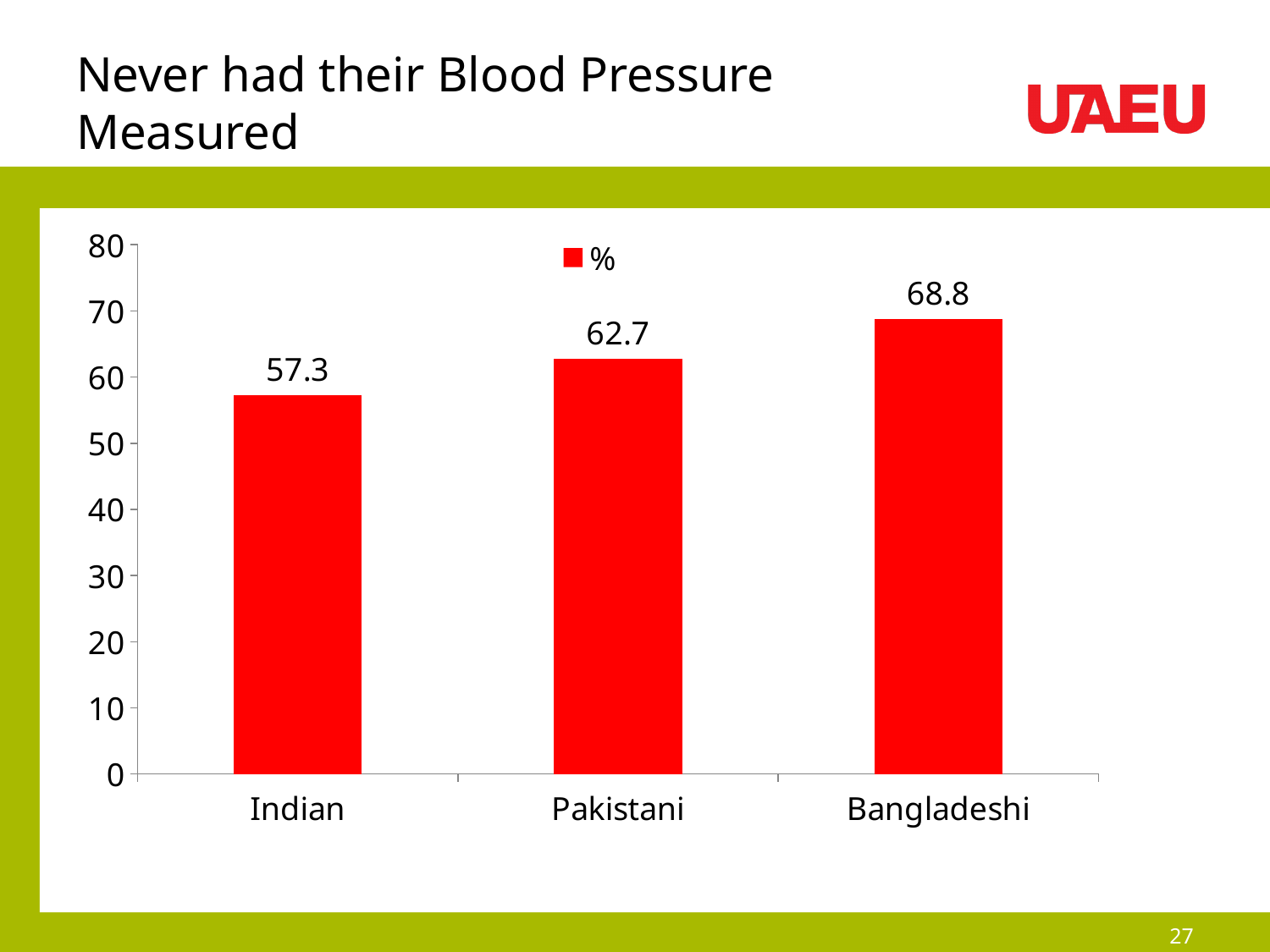
What is the difference between the values for Bangladeshi and Indian? 11.5 What is the value for Bangladeshi? 68.8 What is the difference between the values for Pakistani and Indian? 5.4 Is the value for Indian greater or less than 60? less How many categories are shown on the x axis? 3 What is the value for Indian? 57.3 Which is larger, the value for Pakistani or the value for Bangladeshi? Bangladeshi What kind of chart is shown on the slide? bar chart Which category has the lowest value? Indian Do the values rise or fall from Indian to Bangladeshi along the x axis? rise What is the value for Pakistani? 62.7 Which category has the highest value? Bangladeshi